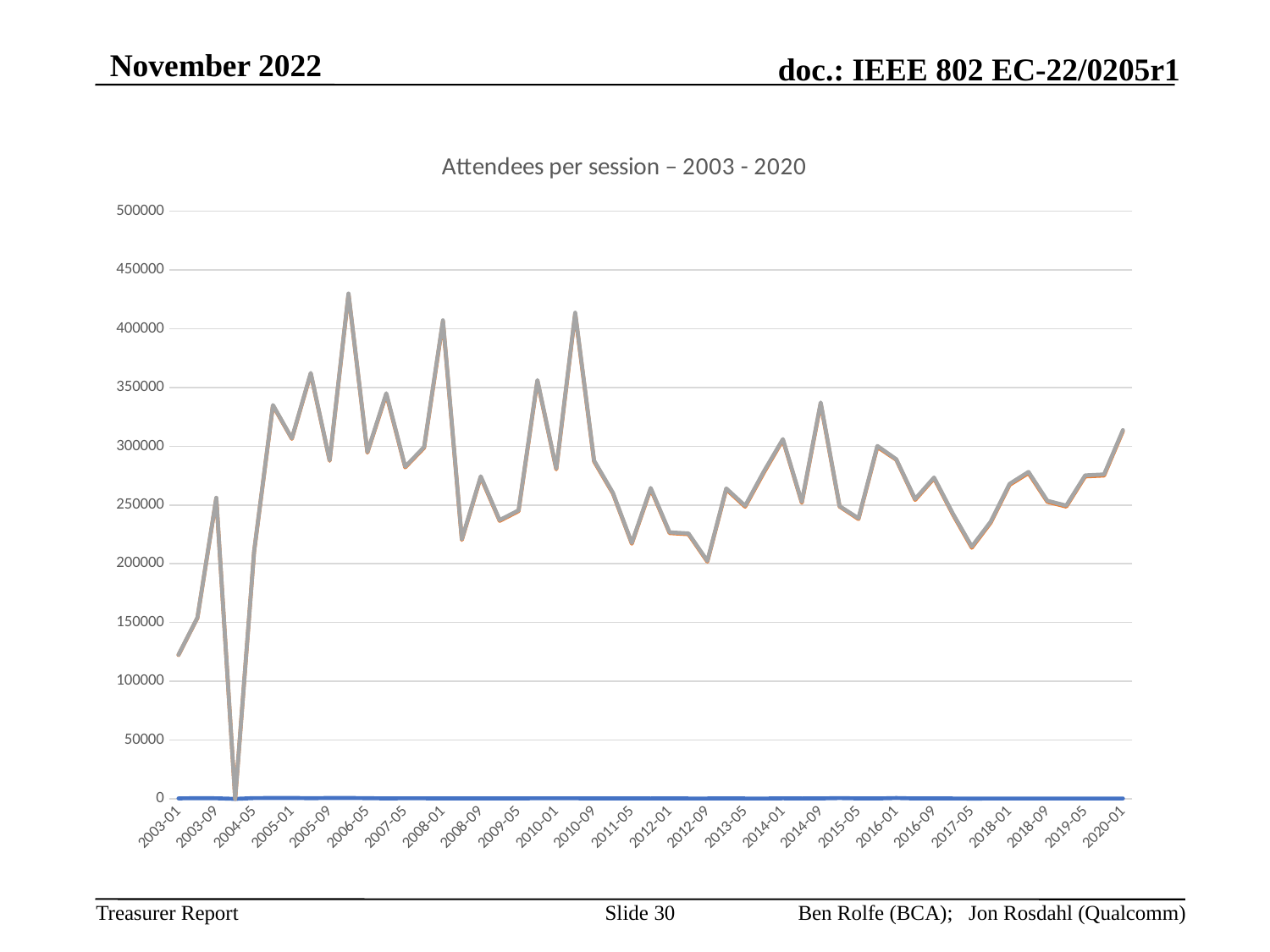
Is the value for 2012-09 greater or less than 250000? less What is the title of the chart? Attendees per session – 2003 - 2020 What is the highest value shown on the vertical axis? 500000 What kind of chart is shown on the slide? line chart Is the value for 2008-01 greater or less than 350000? greater Which is larger, the value for 2008-01 or the value for 2017-05? 2008-01 Is the value for 2014-09 greater or less than 300000? greater Which is larger, the value for 2003-01 or the value for 2020-01? 2020-01 Does the line rise or fall between 2014-09 and 2015-05? fall